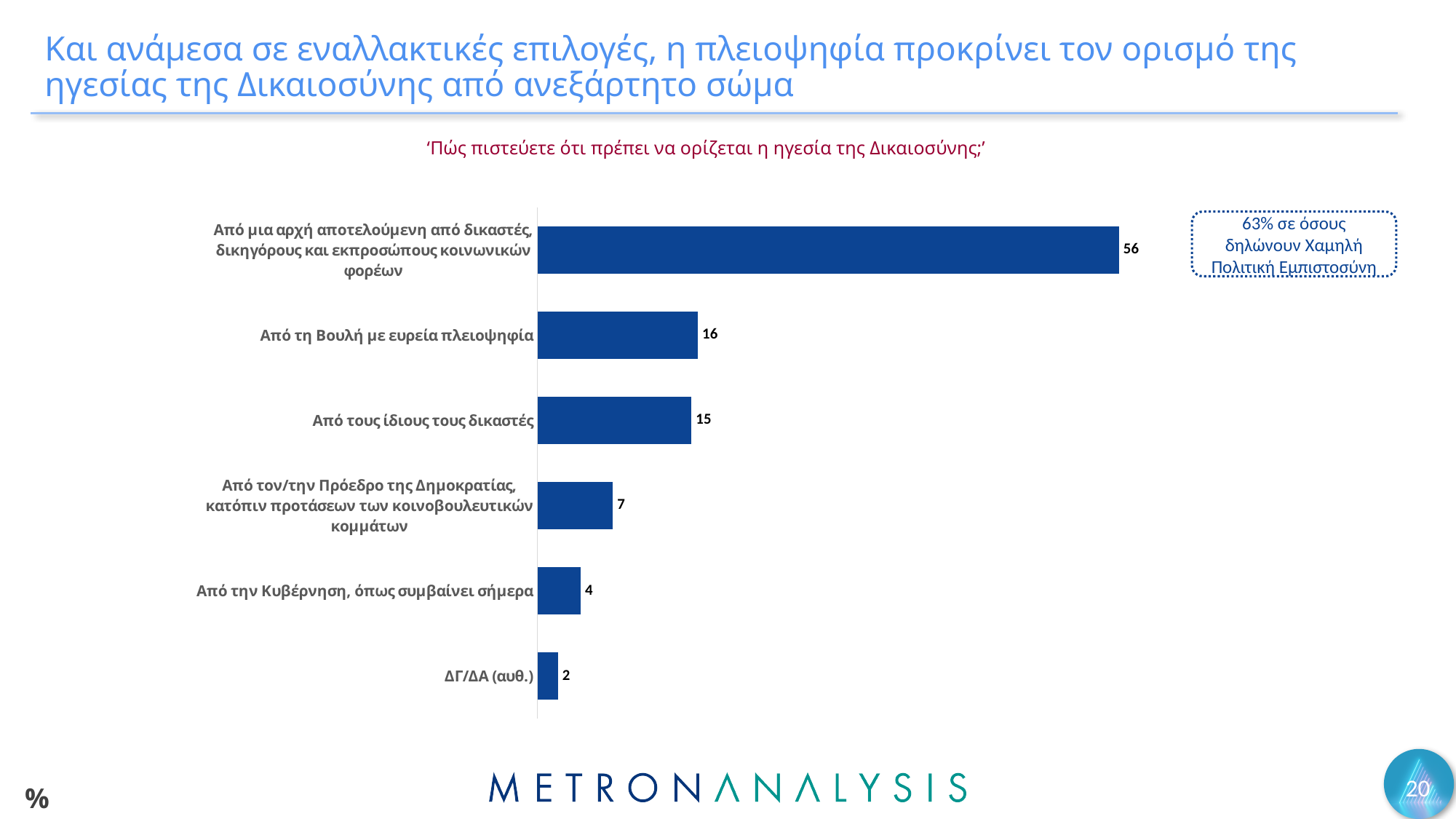
Which category has the highest value? Από μια αρχή αποτελούμενη από δικαστές, δικηγόρους και εκπροσώπους κοινωνικών φορέων Which is larger: the value for 'Από τον/την Πρόεδρο της Δημοκρατίας, κατόπιν προτάσεων των κοινοβουλευτικών κομμάτων' or the value for 'Από την Κυβέρνηση, όπως συμβαίνει σήμερα'? Από τον/την Πρόεδρο της Δημοκρατίας, κατόπιν προτάσεων των κοινοβουλευτικών κομμάτων What is the value for 'Από τους ίδιους τους δικαστές'? 15 Which category has the lowest value? ΔΓ/ΔΑ (αυθ.) What question is shown above the chart? Πώς πιστεύετε ότι πρέπει να ορίζεται η ηγεσία της Δικαιοσύνης; What is the value for 'ΔΓ/ΔΑ (αυθ.)'? 2 How many categories are shown in the chart? 6 What kind of chart is shown on the slide? Bar chart What is the value for 'Από την Κυβέρνηση, όπως συμβαίνει σήμερα'? 4 What is the difference between the value for 'Από μια αρχή αποτελούμενη από δικαστές, δικηγόρους και εκπροσώπους κοινωνικών φορέων' and the value for 'Από τη Βουλή με ευρεία πλειοψηφία'? 40 What is the difference between the value for 'Από τους ίδιους τους δικαστές' and the value for 'Από τον/την Πρόεδρο της Δημοκρατίας, κατόπιν προτάσεων των κοινοβουλευτικών κομμάτων'? 8 What is the value for 'Από τη Βουλή με ευρεία πλειοψηφία'? 16